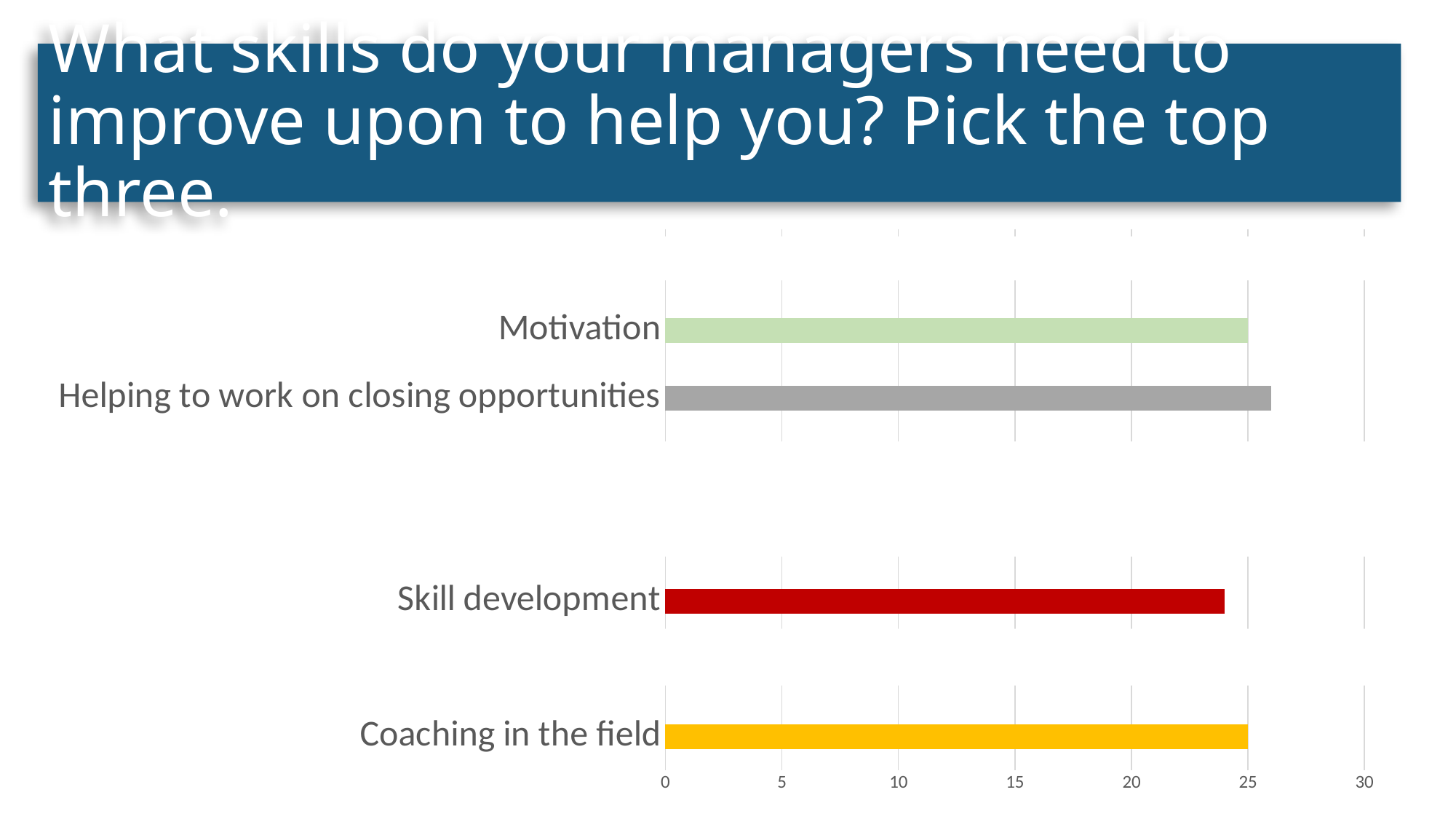
What is the value for Motivation? 25 Is the value for Skill development greater or less than 25? less Which category has the longest bar? Helping to work on closing opportunities Which category has the shortest bar? Skill development What is the value for Coaching in the field? 25 Is the value for Helping to work on closing opportunities greater or less than 25? greater What is the highest value shown on the horizontal axis? 30 Which is larger, the value for Helping to work on closing opportunities or the value for Skill development? Helping to work on closing opportunities Is the value for Motivation greater or less than 20? greater What kind of chart is shown on the slide? Bar chart What colour is the bar for Skill development? Red How many categories are plotted in the chart? 4